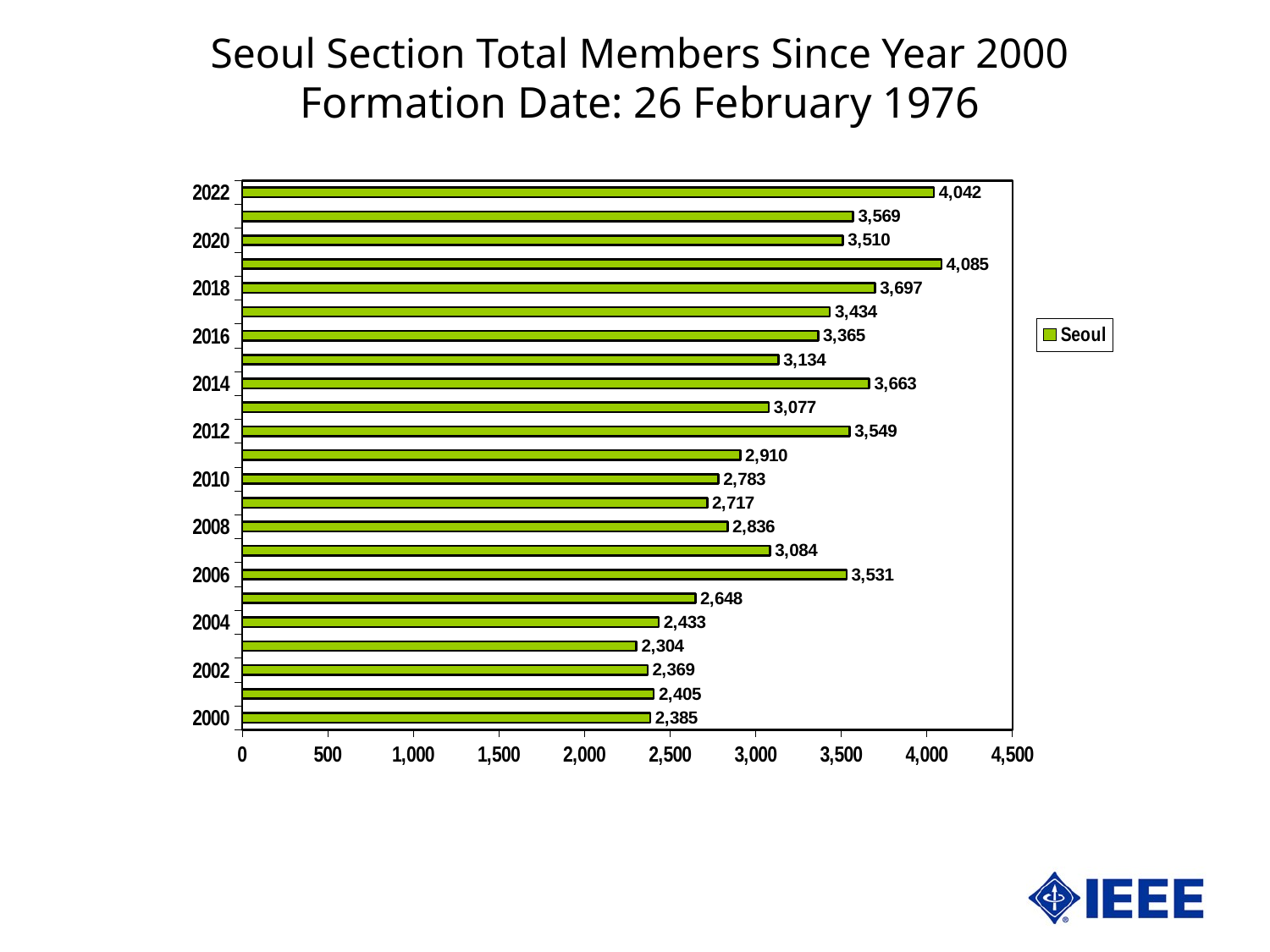
What is the value for 2000? 2,385 What is the difference between the values for 2022 and 2020? 532 What is the name of the series in the legend? Seoul Is the value for 2018 greater or less than 3,500? greater What is the lowest value shown on the chart? 2,304 What is the value for 2012? 3,549 What kind of chart is shown? bar chart What is the value for 2022? 4,042 What is the highest value shown on the chart? 4,085 How many series does the legend list? 1 Which is larger, the value for 2006 or the value for 2008? 2006 How many bars are shown on the chart? 23